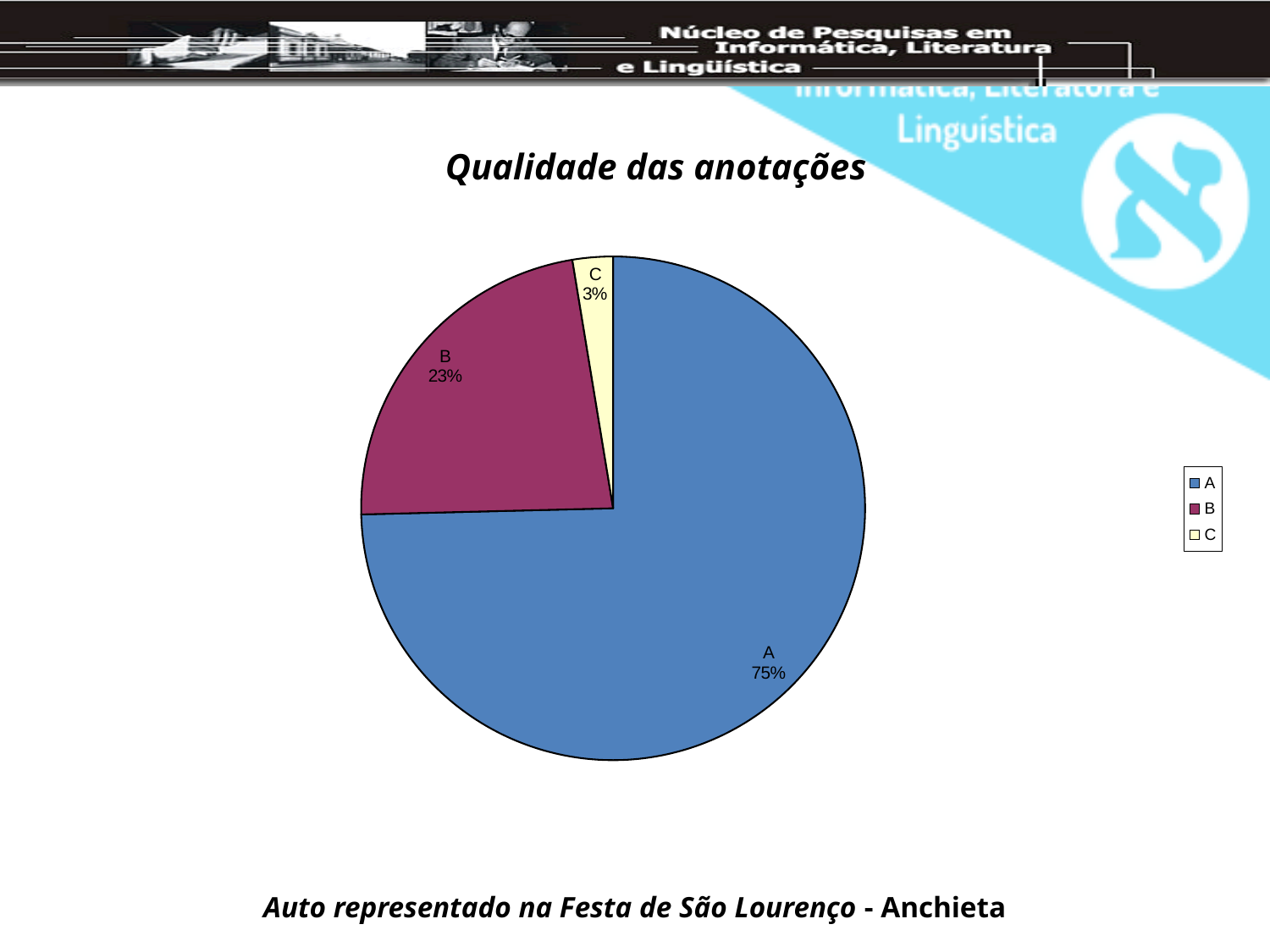
What is the difference in percentage points between slice B and slice C? 20 What share of the pie does slice C represent? 3% What is the title of the chart? Qualidade das anotações How many entries does the legend list? 3 What is the difference in percentage points between slice A and slice B? 52 What kind of chart is shown on the slide? pie chart Which slice is the smallest? C Which is larger, slice B or slice C? B Which slice is the largest? A What share of the pie does slice B represent? 23% How many slices does the pie chart have? 3 What share of the pie does slice A represent? 75%